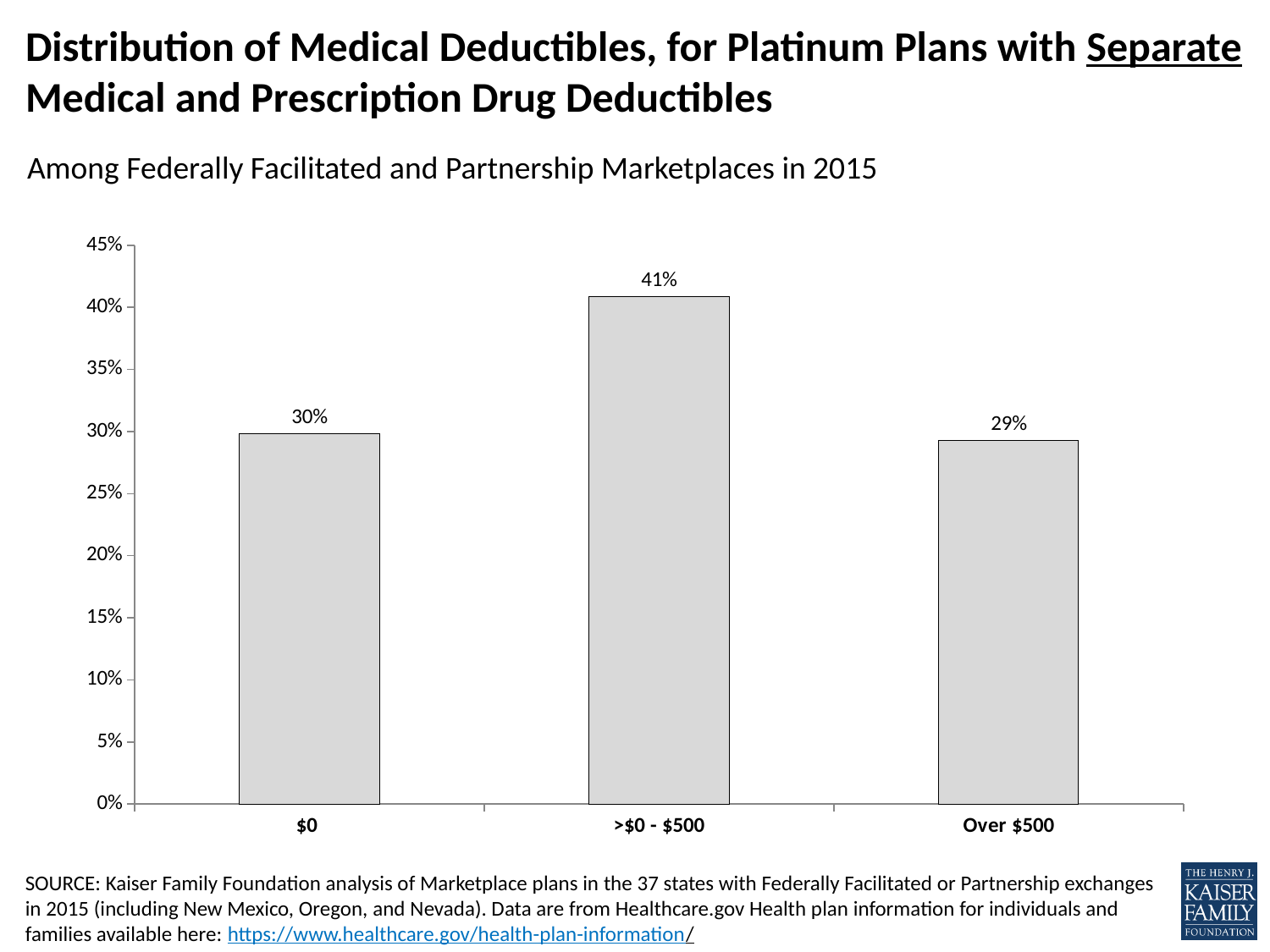
Which deductible category has the highest share of plans? >$0 - $500 What percentage of platinum plans have a medical deductible of Over $500? 29% What percentage of platinum plans have a medical deductible of $0? 30% Is the value for >$0 - $500 greater or less than 35%? greater Which is larger, the share for $0 or the share for >$0 - $500? >$0 - $500 How many deductible categories are shown on the x axis? 3 What is the maximum value shown on the y axis? 45% Which deductible category has the lowest share of plans? Over $500 What is the difference in percentage points between the $0 category and the Over $500 category? 1 What is the difference in percentage points between the >$0 - $500 category and the $0 category? 11 What percentage of platinum plans have a medical deductible of >$0 - $500? 41% What kind of chart is shown on the slide? bar chart